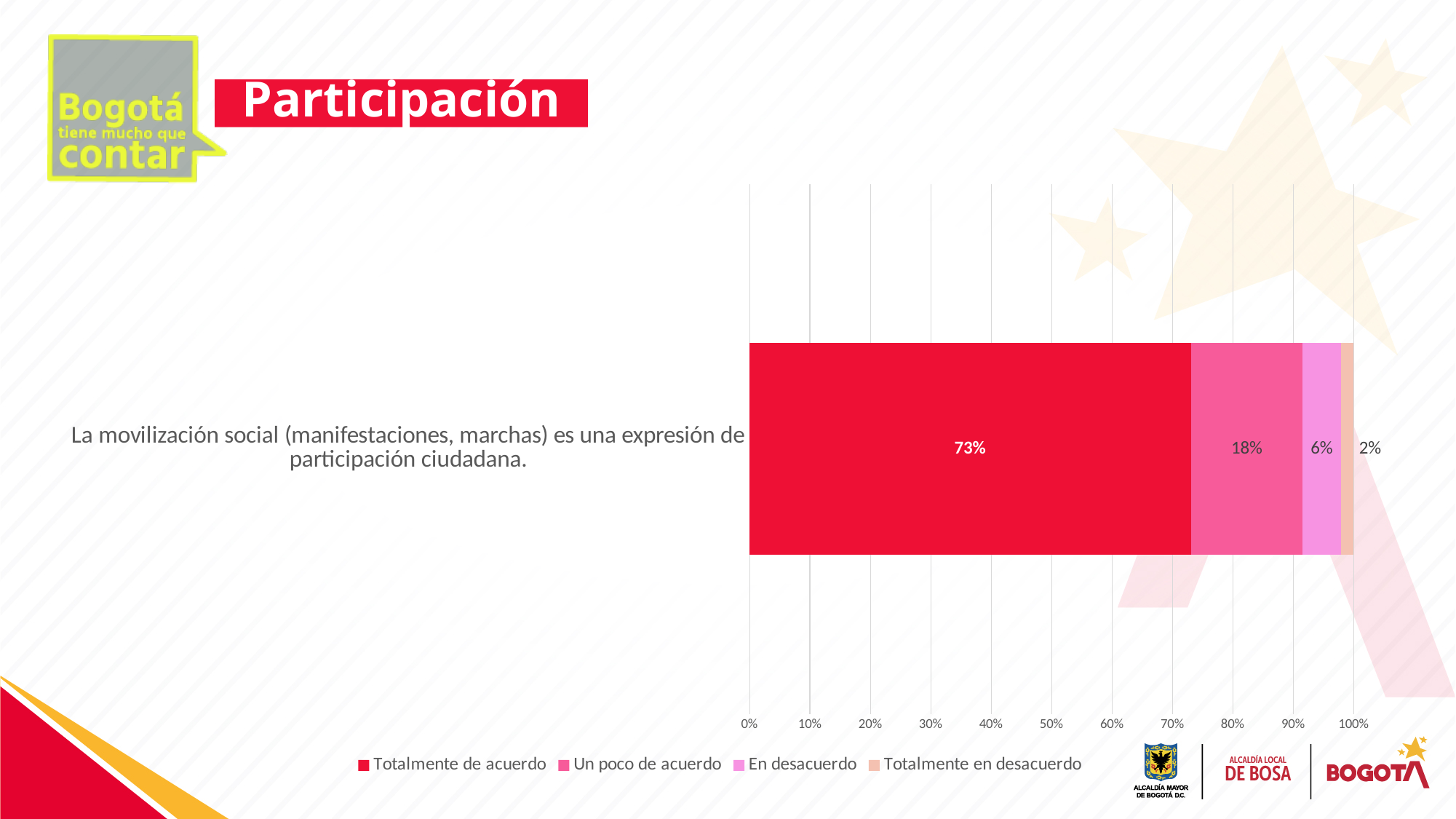
Is the value for "Totalmente de acuerdo" greater or less than 70%? greater Which response option has the highest share? Totalmente de acuerdo What is the combined share of "Totalmente de acuerdo" and "Un poco de acuerdo"? 91% What is the difference between the "Totalmente de acuerdo" and "Un poco de acuerdo" shares? 55% What percentage of respondents answered "Totalmente en desacuerdo"? 2% What percentage of respondents answered "Un poco de acuerdo"? 18% What percentage of respondents answered "En desacuerdo"? 6% Which is larger, the share for "En desacuerdo" or for "Totalmente en desacuerdo"? En desacuerdo What kind of chart is shown on the slide? Stacked bar chart What percentage of respondents answered "Totalmente de acuerdo" to the statement "La movilización social (manifestaciones, marchas) es una expresión de participación ciudadana"? 73% How many series does the legend list? 4 Which response option has the lowest share? Totalmente en desacuerdo